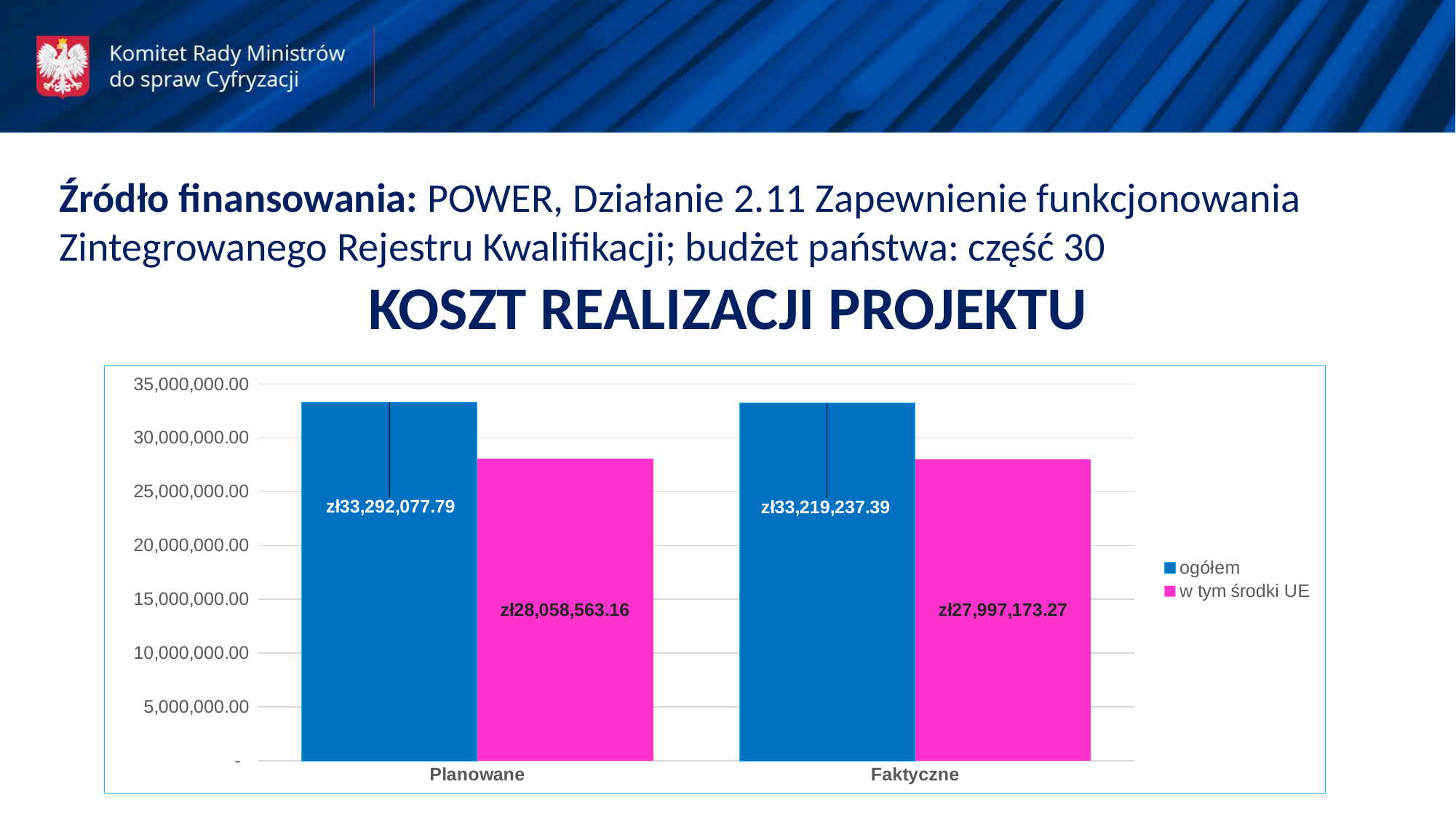
Is the 'w tym środki UE' value for Faktyczne greater or less than 30,000,000.00? less Which bar on the chart has the lowest value? w tym środki UE for Faktyczne For Faktyczne, which is larger: 'ogółem' or 'w tym środki UE'? ogółem What is the value of the 'ogółem' bar for Planowane? zł33,292,077.79 Which bar on the chart has the highest value? ogółem for Planowane What type of chart is shown on the slide? bar chart What is the value of the 'ogółem' bar for Faktyczne? zł33,219,237.39 What is the value of the 'w tym środki UE' bar for Planowane? zł28,058,563.16 How many series does the legend list? 2 What is the difference between the 'ogółem' and 'w tym środki UE' values for Planowane? zł5,233,514.63 What is the value of the 'w tym środki UE' bar for Faktyczne? zł27,997,173.27 What is the difference between the 'ogółem' values for Planowane and Faktyczne? zł72,840.40